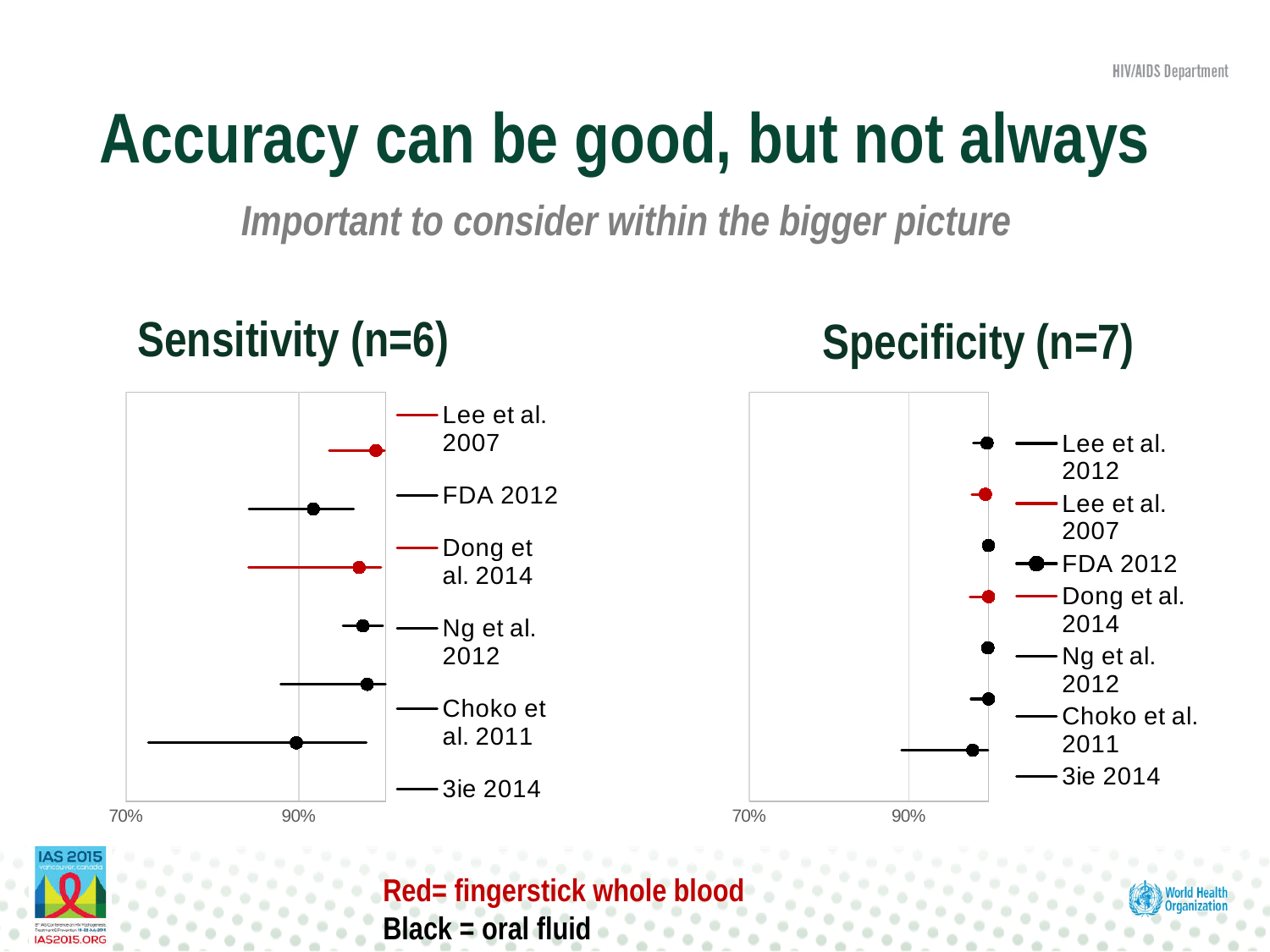
How many data points are plotted in the Sensitivity (n=6) chart? 6 In the Specificity (n=7) chart, is the value for Lee et al. 2012 greater or less than 90%? greater How many data points are plotted in the Specificity (n=7) chart? 7 According to the slide, what do the red markers represent? Fingerstick whole blood In the Specificity (n=7) chart, is the value for Dong et al. 2014 greater or less than 90%? greater What kind of chart is the Sensitivity (n=6) chart? Dot plot with error bars (forest plot) How many series does the legend of the Sensitivity (n=6) chart list? 6 In the Sensitivity (n=6) chart, what colour is the marker for Lee et al. 2007? Red In the Sensitivity (n=6) chart, is the value for Lee et al. 2007 greater or less than 90%? greater How many series does the legend of the Specificity (n=7) chart list? 7 Which chart plots more studies, Sensitivity or Specificity? Specificity